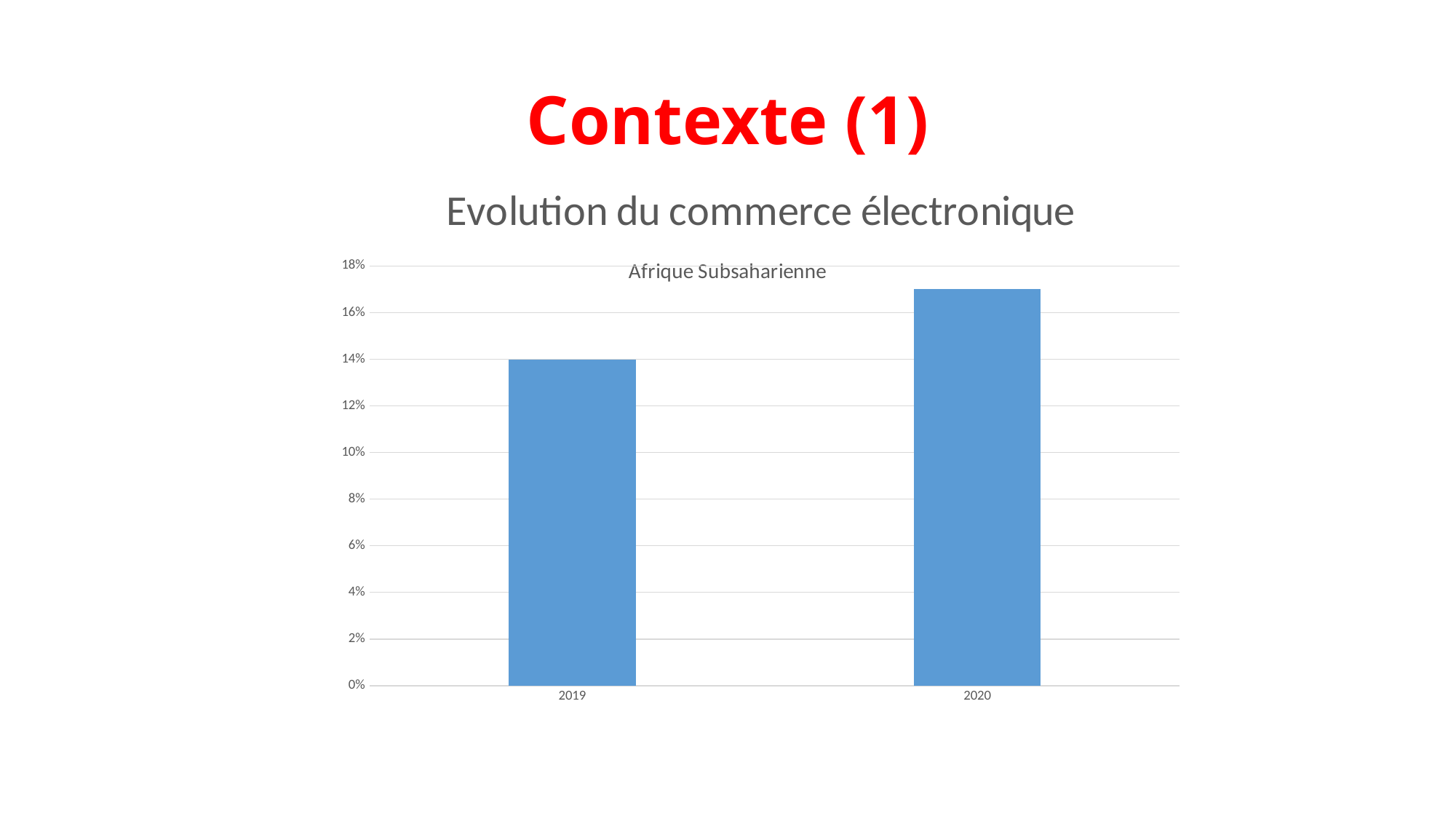
How many bars (categories) does the chart show? 2 What is the title of the chart? Evolution du commerce électronique Which is larger, the value for 2019 or the value for 2020? 2020 Which year has the lowest value? 2019 What is the value for 2019? 14% What series label is shown inside the chart area? Afrique Subsaharienne Is the value for 2019 greater or less than 10%? greater Which year has the highest value? 2020 What kind of chart is shown on the slide? bar chart Do the values rise or fall from 2019 to 2020? rise Is the value for 2020 greater or less than 16%? greater Is the value for 2020 greater or less than 18%? less